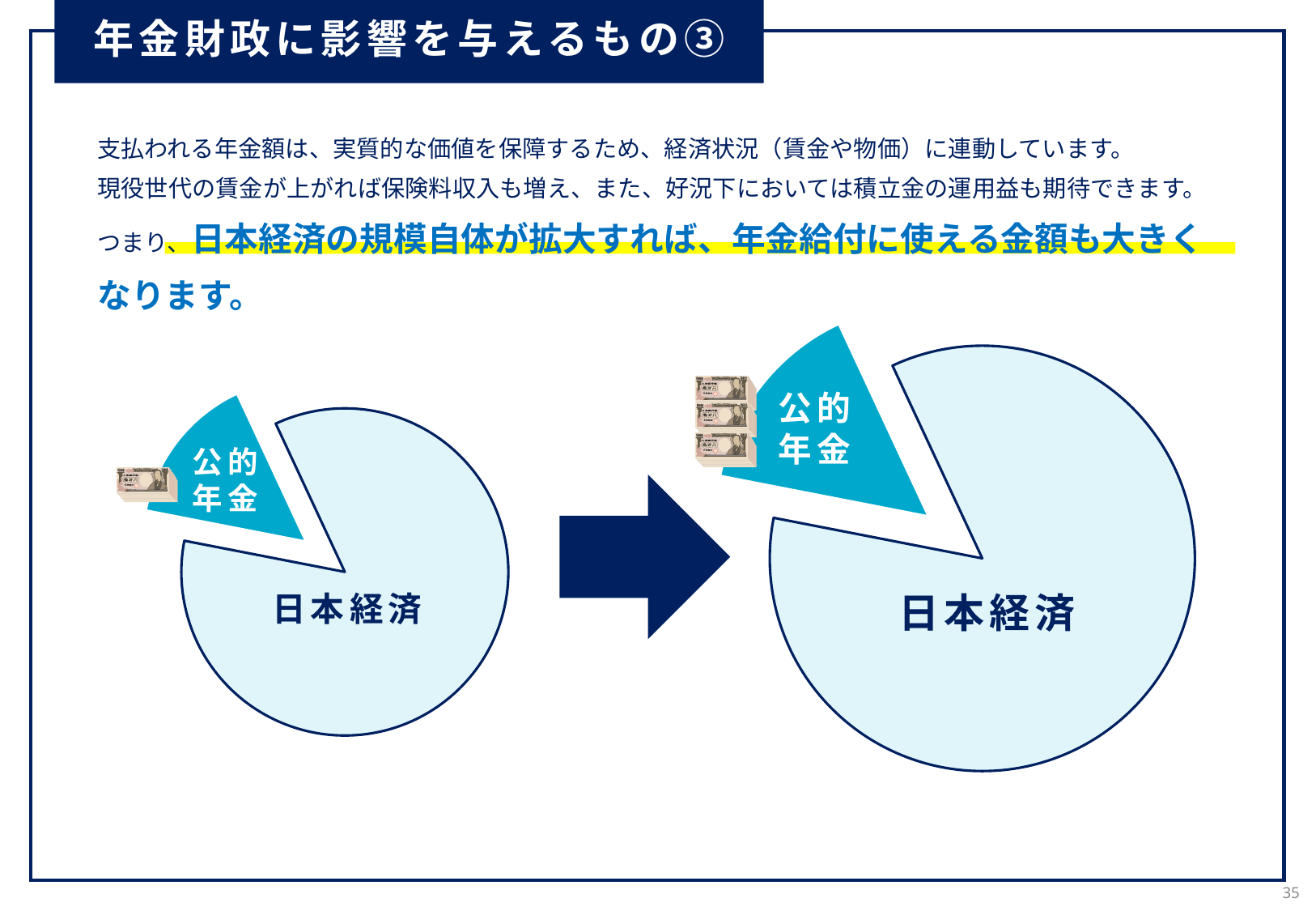
In the right pie chart, which segment is larger, 日本経済 or 公的年金? 日本経済 Which of the two pie charts is drawn larger, the left one or the right one? the right one What kind of chart is shown on the right side of the slide? pie chart What kind of chart is shown on the left side of the slide? pie chart What is the label of the segment pulled out from the pie in the left chart? 公的年金 In the right pie chart, how many labelled segments are there? 2 In the left pie chart, which segment is larger, 日本経済 or 公的年金? 日本経済 In the left pie chart, which segment is the smallest? 公的年金 In the left pie chart, how many labelled segments are there? 2 In the right pie chart, which segment is the largest? 日本経済